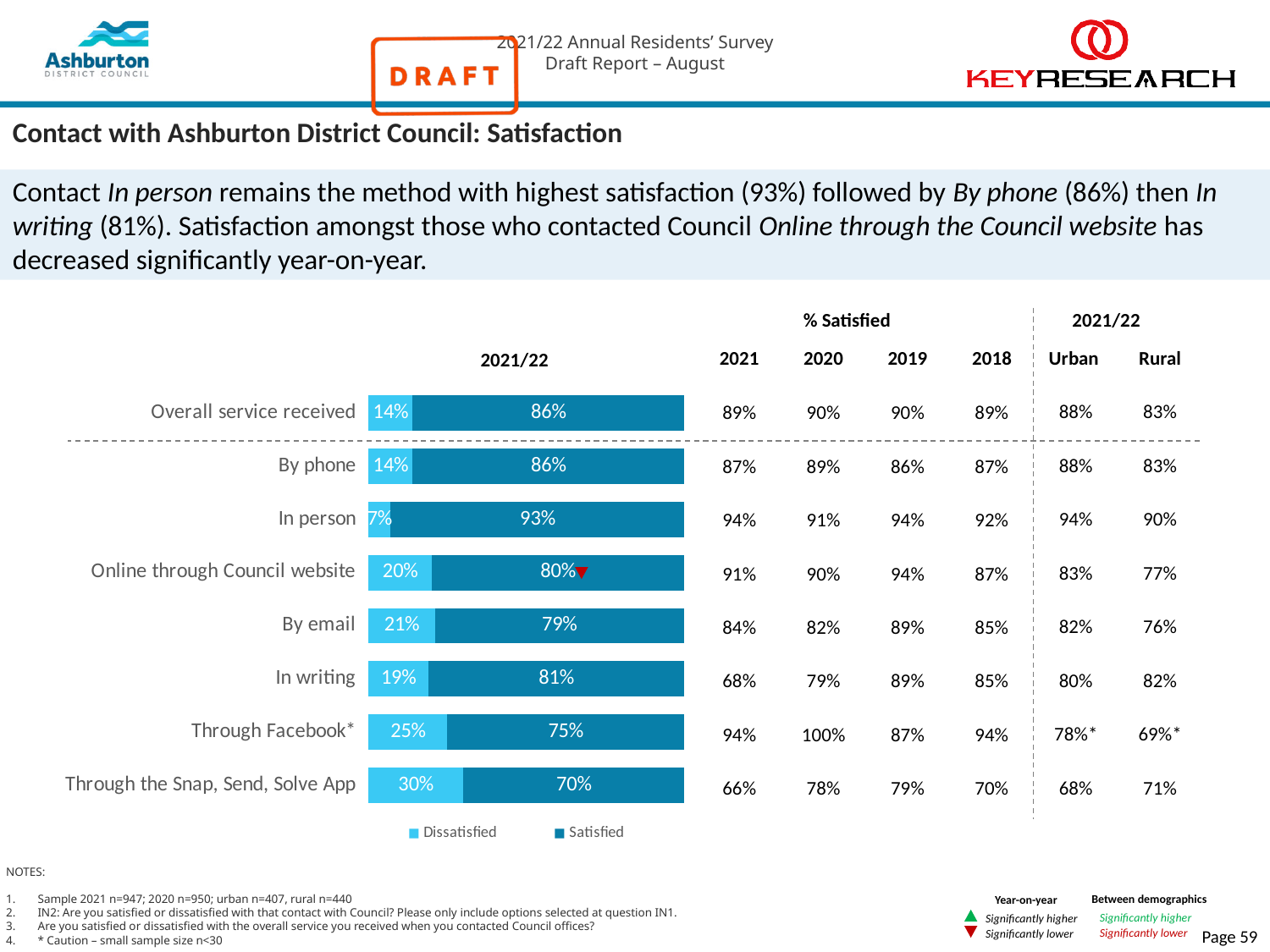
What percentage of respondents were satisfied with contact In person in 2021/22? 93% How many series does the chart legend list? 2 What type of chart is used to show satisfaction by contact method? Stacked bar chart What is the difference in satisfied percentage between In person and Through Facebook*? 18% How many contact methods are shown as bars in the chart? 8 What are the two legend entries of the chart? Dissatisfied and Satisfied Which contact method has the lowest satisfied percentage in the bar chart? Through the Snap, Send, Solve App Which contact method has the highest satisfied percentage in the bar chart? In person What is the satisfied percentage for contact By email? 79% Which has a higher dissatisfied percentage: By email or In writing? By email What percentage of respondents were dissatisfied with contact Through the Snap, Send, Solve App? 30% What is the total of the Dissatisfied and Satisfied segments for the Online through Council website bar? 100%